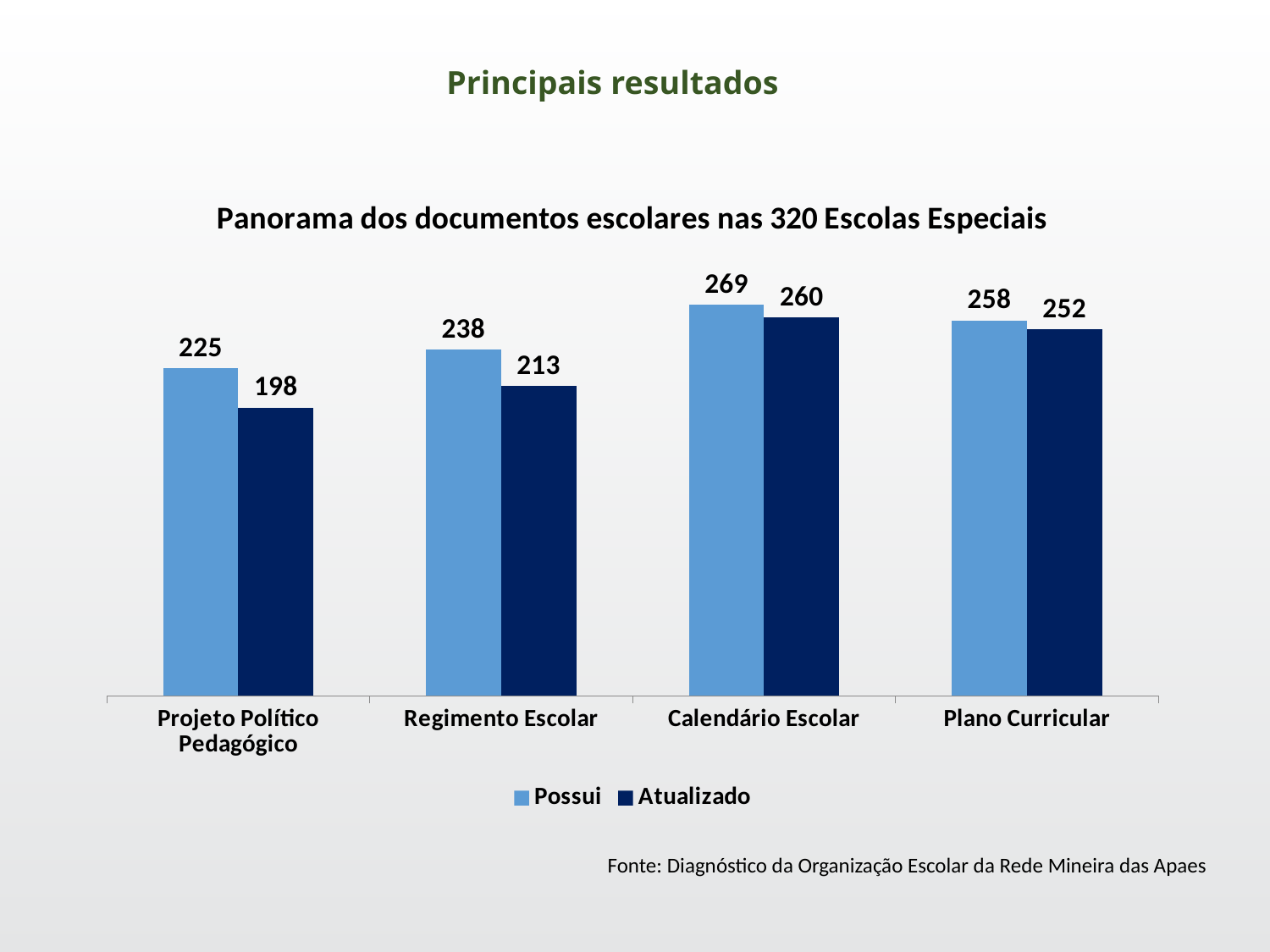
What is the 'Possui' value for Regimento Escolar? 238 How many categories are shown on the x axis? 4 What is the 'Atualizado' value for Projeto Político Pedagógico? 198 What is the difference between the 'Possui' and 'Atualizado' values for Calendário Escolar? 9 What type of chart is shown? Bar chart What is the 'Atualizado' value for Plano Curricular? 252 What is the difference between the 'Possui' and 'Atualizado' values for Regimento Escolar? 25 Which category has the lowest 'Atualizado' value? Projeto Político Pedagógico Which is larger: the 'Atualizado' value for Plano Curricular or the 'Possui' value for Regimento Escolar? Atualizado for Plano Curricular What is the 'Possui' value for Calendário Escolar? 269 How many series does the legend list? 2 Which category has the highest 'Possui' value? Calendário Escolar